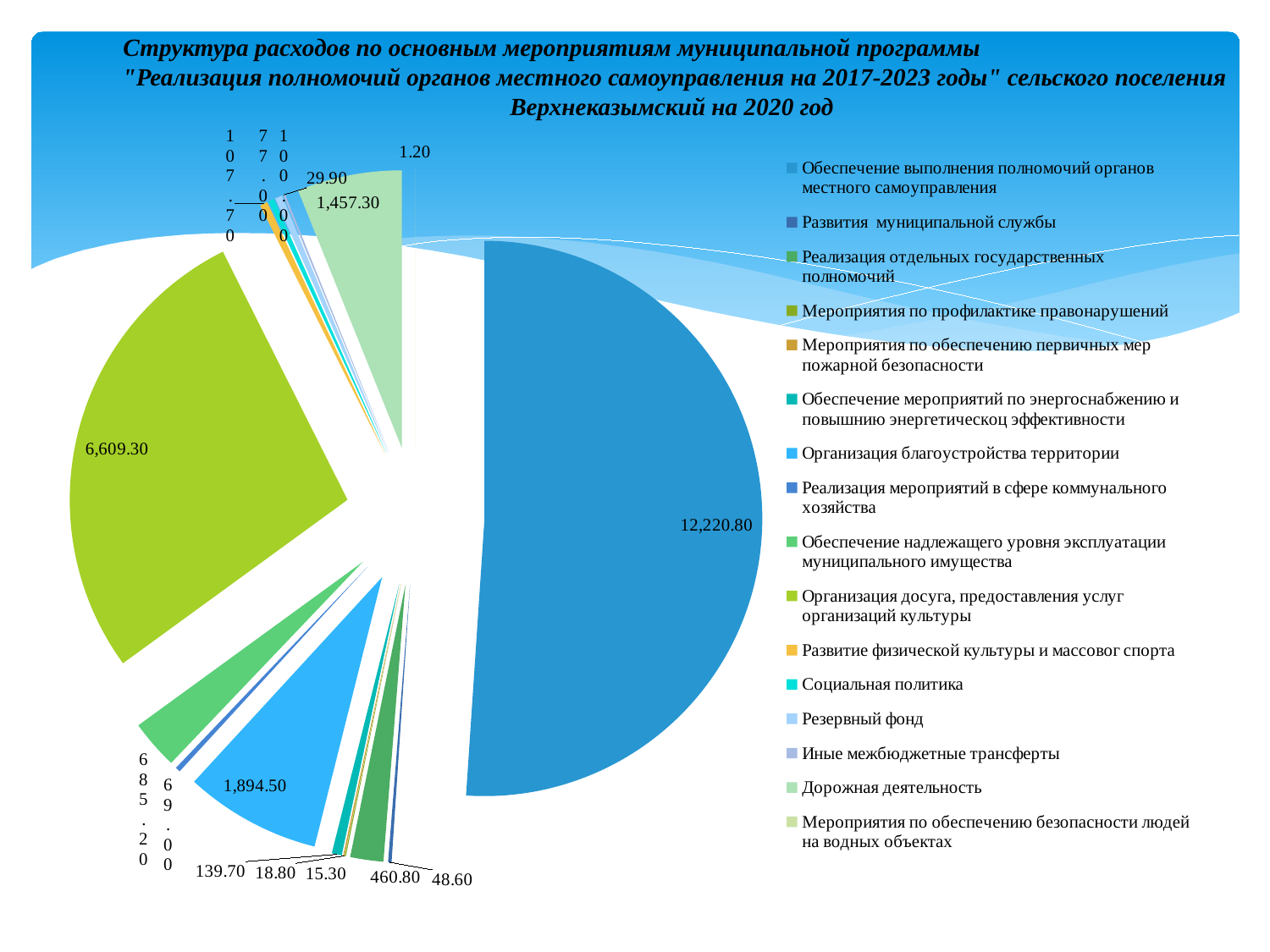
What is the value for Организация досуга, предоставления услуг организаций культуры? 6,609.30 What kind of chart is shown on the slide? Pie chart What year does the chart title say the expenditure structure refers to? 2020 What is the value for Организация благоустройства территории? 1,894.50 Which category has the largest slice in the pie chart? Обеспечение выполнения полномочий органов местного самоуправления What is the difference between the values 12,220.80 and 6,609.30 shown on the pie chart? 5,611.50 What is the value of the largest slice in the pie chart? 12,220.80 What is the value for Дорожная деятельность? 1,457.30 Which category has the smallest slice in the pie chart? Мероприятия по обеспечению безопасности людей на водных объектах How many categories does the legend of the pie chart list? 16 Which is larger: the slice for Организация благоустройства территории or the slice for Дорожная деятельность? Организация благоустройства территории What is the smallest value labelled on the pie chart? 1.20